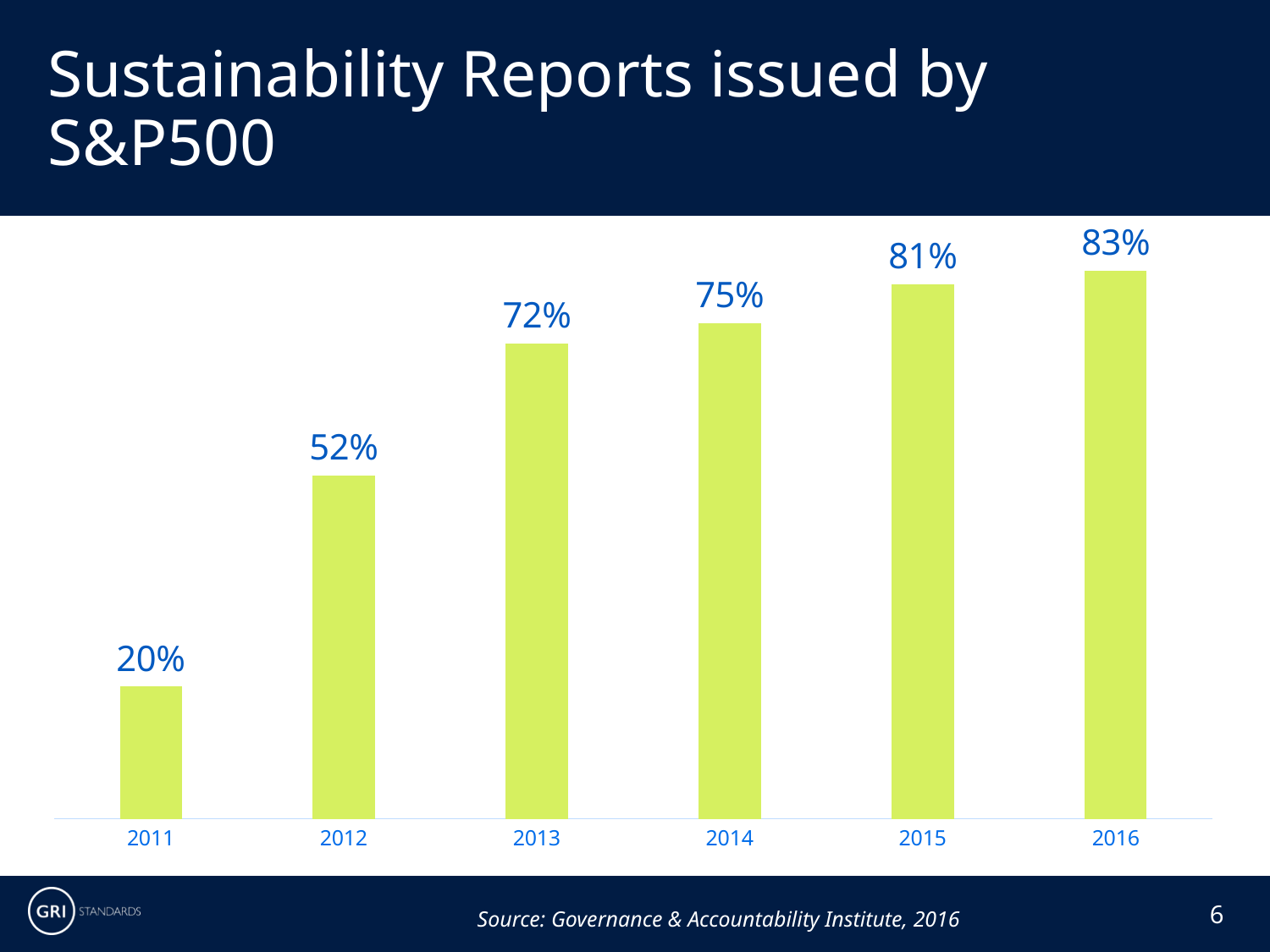
How many years are shown on the chart? 6 What is the value shown for 2016? 83% What is the difference between the values for 2012 and 2011? 32% What is the source cited for the chart data? Governance & Accountability Institute, 2016 What is the value shown for 2013? 72% What percentage of S&P500 companies issued sustainability reports in 2011? 20% What is the difference between the values for 2016 and 2015? 2% Which year has a larger value, 2013 or 2014? 2014 Do the values rise or fall from 2011 to 2016? Rise Which year has the lowest value? 2011 What kind of chart is shown on the slide? Bar chart Which year has the highest value? 2016